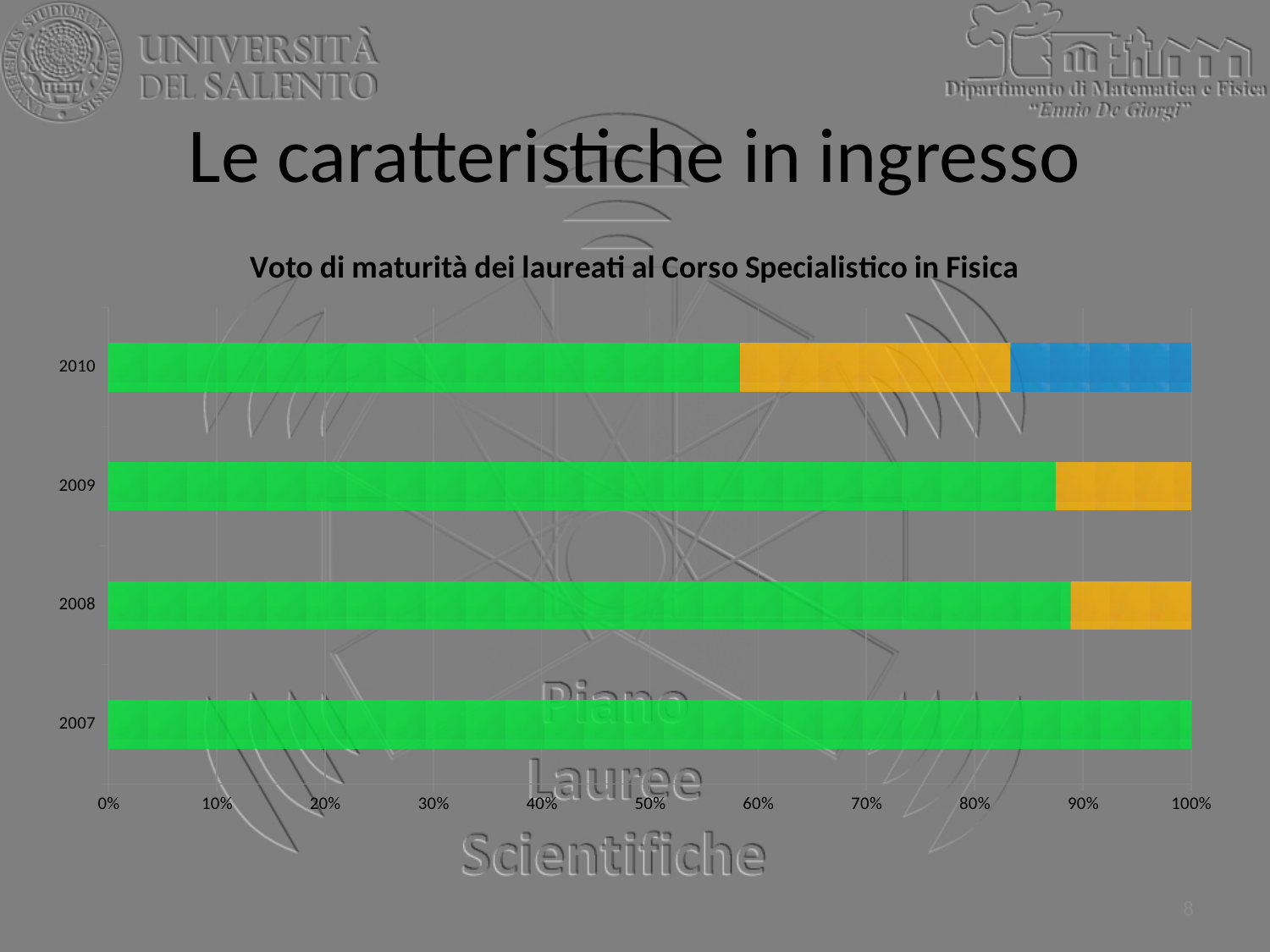
What kind of chart is shown on the slide? stacked bar chart Which year has the smallest green segment? 2010 Which year has the larger green segment, 2010 or 2009? 2009 Which year is the only one with a blue segment? 2010 Which year has the larger orange segment, 2010 or 2008? 2010 What percentage does the green segment for 2007 reach on the axis? 100% What is the title of the chart? Voto di maturità dei laureati al Corso Specialistico in Fisica Is the green segment for 2010 greater or less than 60%? less Which year has the largest green segment? 2007 How many years (categories) are shown on the chart? 4 Is the green segment for 2009 greater or less than 80%? greater